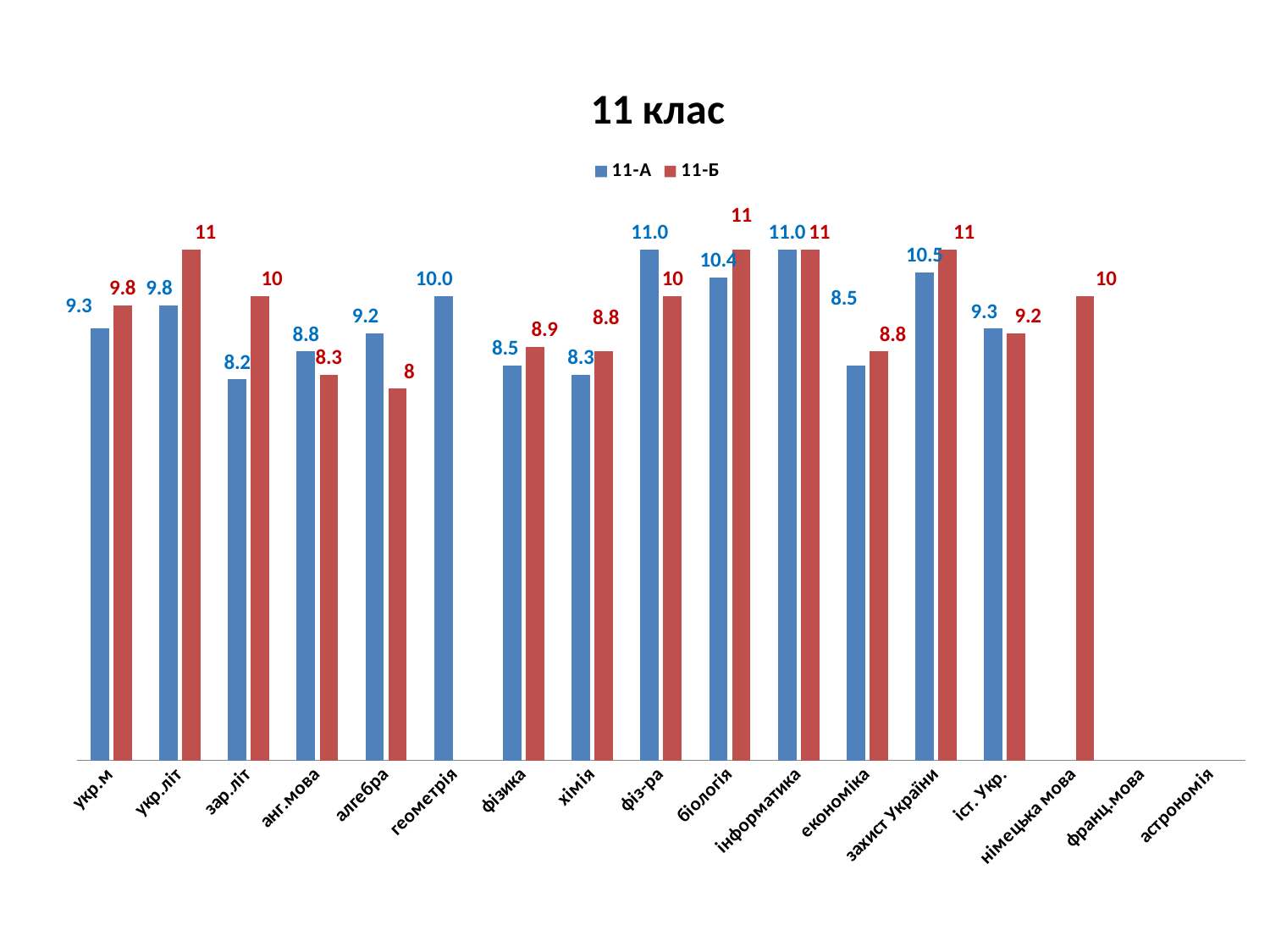
What is the title of the chart? 11 клас What is the difference between the 11-Б and 11-А values in зар.літ? 1.8 What is the value for 11-А in захист України? 10.5 What is the value for 11-Б in алгебра? 8 Which is larger in алгебра, the value for 11-А or for 11-Б? 11-А Which category has the lowest value for 11-Б? алгебра What kind of chart is shown on the slide? Bar chart Which is larger in укр.літ, the value for 11-А or for 11-Б? 11-Б How many series does the legend list? 2 What is the value for 11-А in зар.літ? 8.2 What is the value for 11-Б in німецька мова? 10 Which category has the lowest value for 11-А? зар.літ